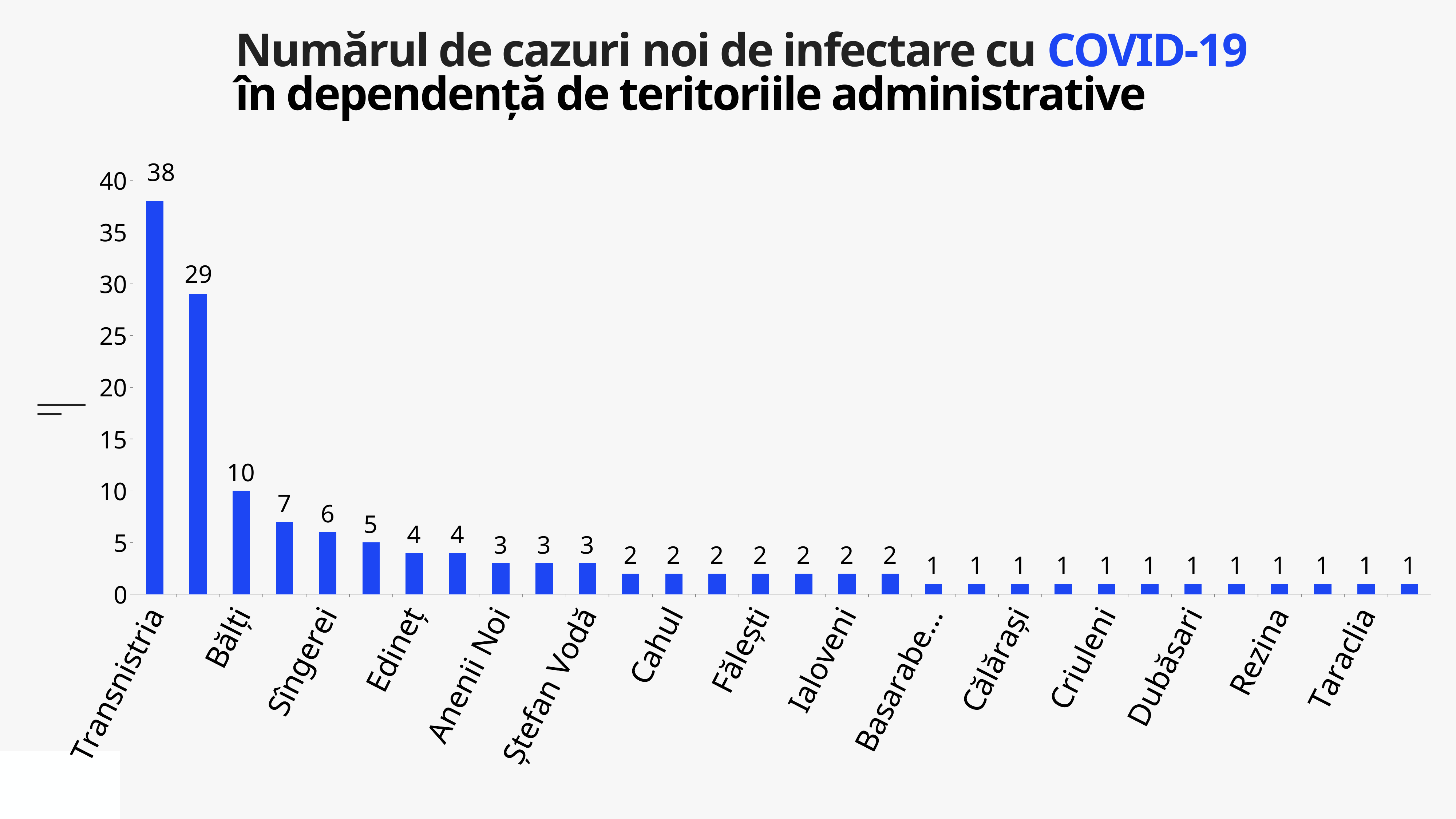
Which territory has the highest number of new cases? Transnistria Which has a larger value, Bălți or Sîngerei? Bălți What is the value for Bălți? 10 Do the values rise or fall from left to right along the x axis? fall What kind of chart is shown on the slide? bar chart What is the difference between the values for Transnistria and Bălți? 28 What is the value for Sîngerei? 6 What is the value for Cahul? 2 What is the value for Taraclia? 1 What is the value for Transnistria? 38 Is the value for Transnistria greater or less than 35? greater What is the value for Edineț? 4